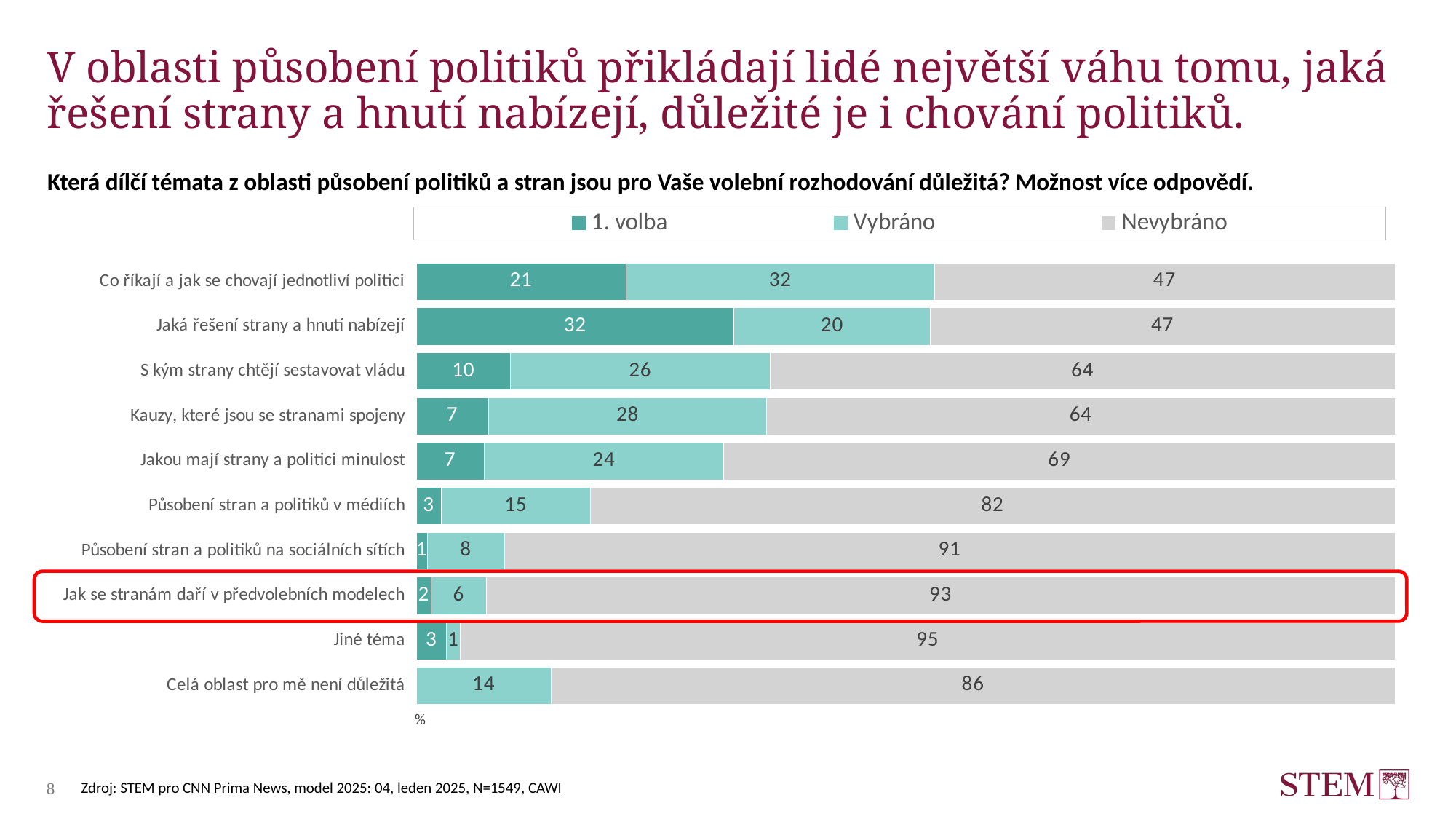
What is the value of 'Vybráno' for 'Co říkají a jak se chovají jednotliví politici'? 32 What is the combined value of '1. volba' and 'Vybráno' for 'Co říkají a jak se chovají jednotliví politici'? 53 What is the difference between the 'Nevybráno' values for 'Působení stran a politiků v médiích' and 'Jakou mají strany a politici minulost'? 13 How many series does the legend list? 3 How many categories are shown on the chart? 10 What is the value of 'Nevybráno' for 'Jak se stranám daří v předvolebních modelech'? 93 Which category has the highest 'Nevybráno' value? Jiné téma Which is larger: the 'Vybráno' value for 'Kauzy, které jsou se stranami spojeny' or for 'S kým strany chtějí sestavovat vládu'? Kauzy, které jsou se stranami spojeny Which category is highlighted with a red outline on the chart? Jak se stranám daří v předvolebních modelech What kind of chart is shown on the slide? stacked bar chart Which category has the highest '1. volba' value? Jaká řešení strany a hnutí nabízejí What is the value of '1. volba' for 'Jaká řešení strany a hnutí nabízejí'? 32